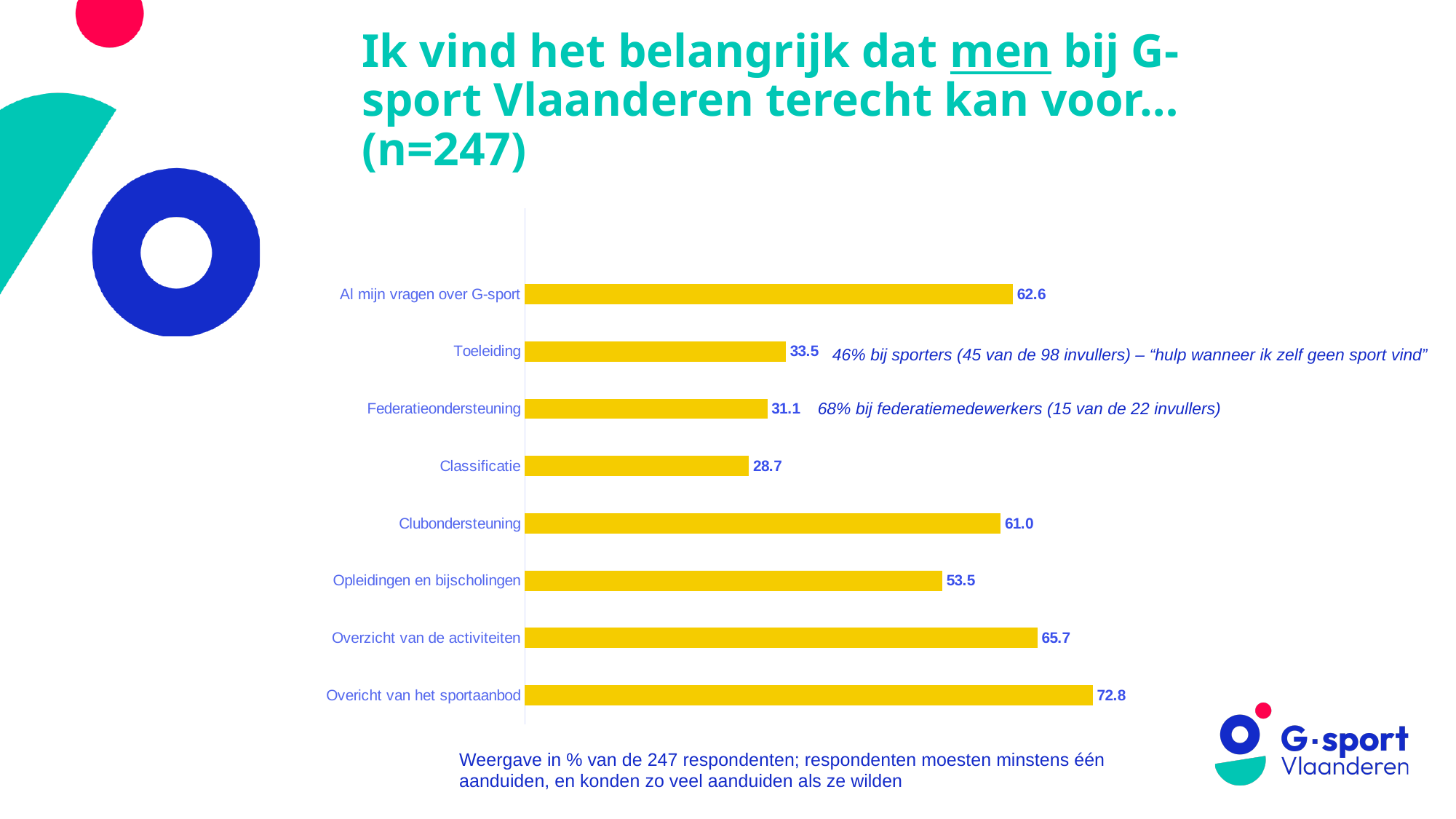
What kind of chart is shown on the slide? Bar chart How many categories are shown in the chart? 8 What is the value for 'Opleidingen en bijscholingen'? 53.5 What is the value for 'Classificatie'? 28.7 What is the value for 'Toeleiding'? 33.5 What is the difference between 'Clubondersteuning' and 'Federatieondersteuning'? 29.9 Which is larger: 'Clubondersteuning' or 'Opleidingen en bijscholingen'? Clubondersteuning What is the value for 'Overicht van het sportaanbod'? 72.8 Which category has the highest value? Overicht van het sportaanbod What colour are the bars in the chart? Yellow What is the difference between 'Overzicht van de activiteiten' and 'Al mijn vragen over G-sport'? 3.1 Which category has the lowest value? Classificatie